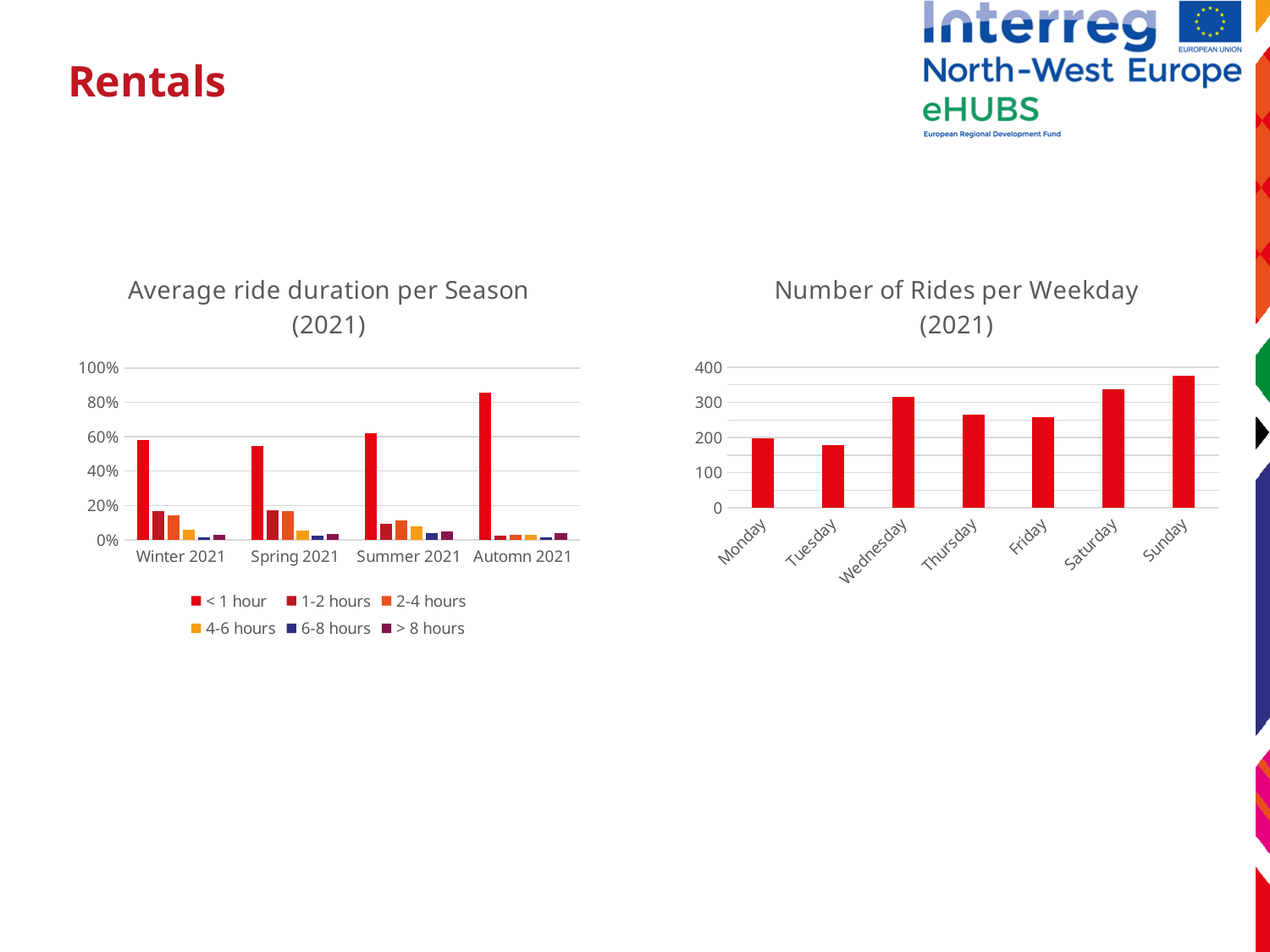
In "Number of Rides per Weekday (2021)", is the value for Sunday greater or less than 300? greater In "Number of Rides per Weekday (2021)", which weekday has the highest number of rides? Sunday In "Number of Rides per Weekday (2021)", which weekday has the lowest number of rides? Tuesday What type of chart is "Number of Rides per Weekday (2021)"? bar chart How many series does the legend of "Average ride duration per Season (2021)" list? 6 In "Number of Rides per Weekday (2021)", which has more rides, Saturday or Friday? Saturday In "Number of Rides per Weekday (2021)", how many weekdays are shown on the x axis? 7 In "Average ride duration per Season (2021)", which season has the highest share of rides under 1 hour? Automn 2021 In "Number of Rides per Weekday (2021)", is the value for Friday greater or less than 300? less In "Average ride duration per Season (2021)", how many seasons are shown on the x axis? 4 In "Number of Rides per Weekday (2021)", is the value for Tuesday greater or less than 200? less